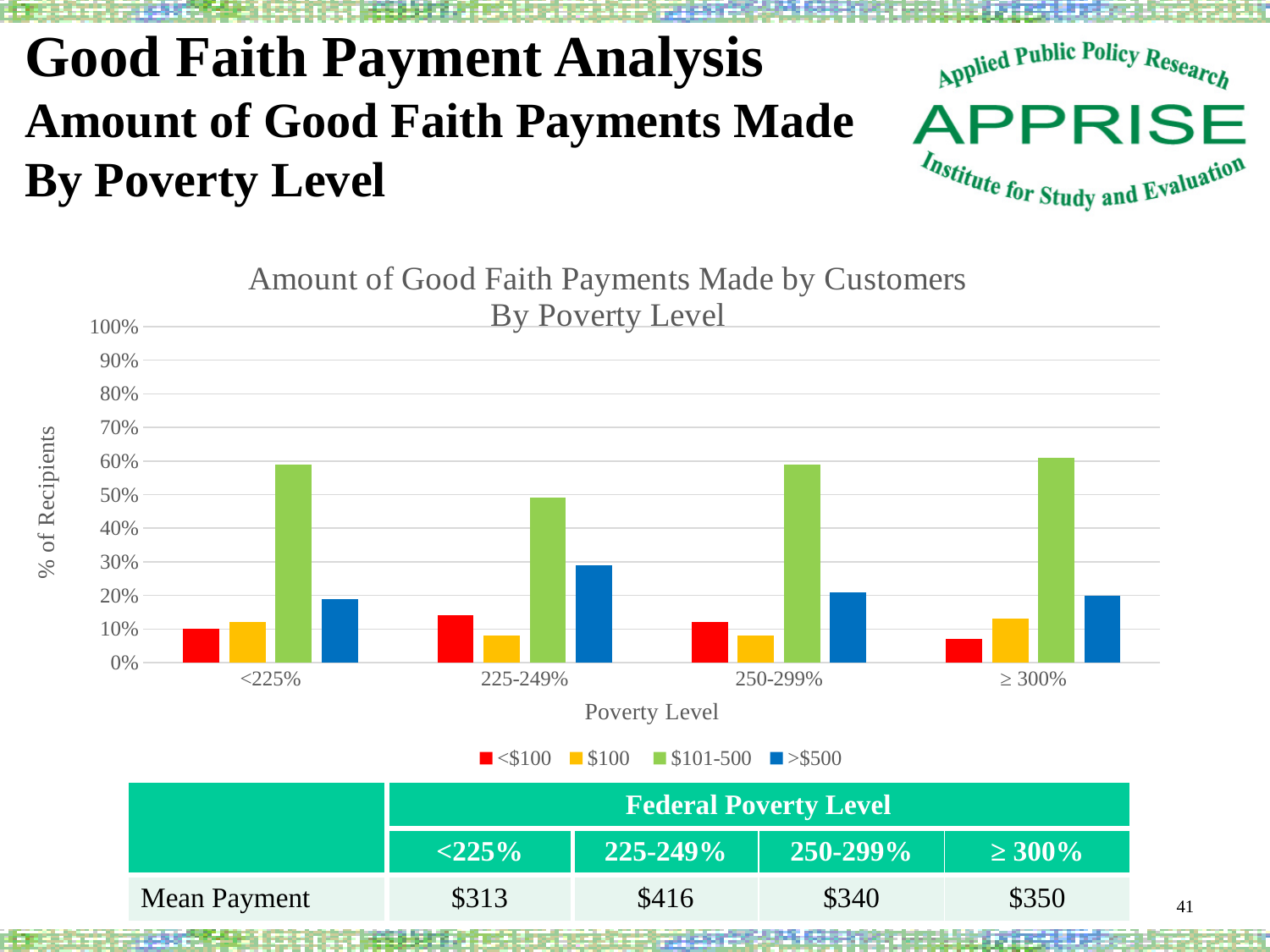
Is the value for $101-500 in the <225% group greater or less than 50%? greater What kind of chart is shown on the slide? bar chart Is the value for <$100 in the ≥ 300% group greater or less than 10%? less How many poverty level categories are shown on the x axis of the chart? 4 What is the label of the chart's y axis? % of Recipients What is the label of the chart's x axis? Poverty Level Is the value for >$500 in the 225-249% group greater or less than 20%? greater In the 225-249% group, which is larger: the >$500 bar or the <$100 bar? >$500 Which payment amount series has the shortest bar in the ≥ 300% poverty level group? <$100 How many series does the chart's legend list? 4 Which payment amount series has the tallest bar in the 225-249% poverty level group? $101-500 For the $101-500 series, which group has the larger value: <225% or 225-249%? <225%